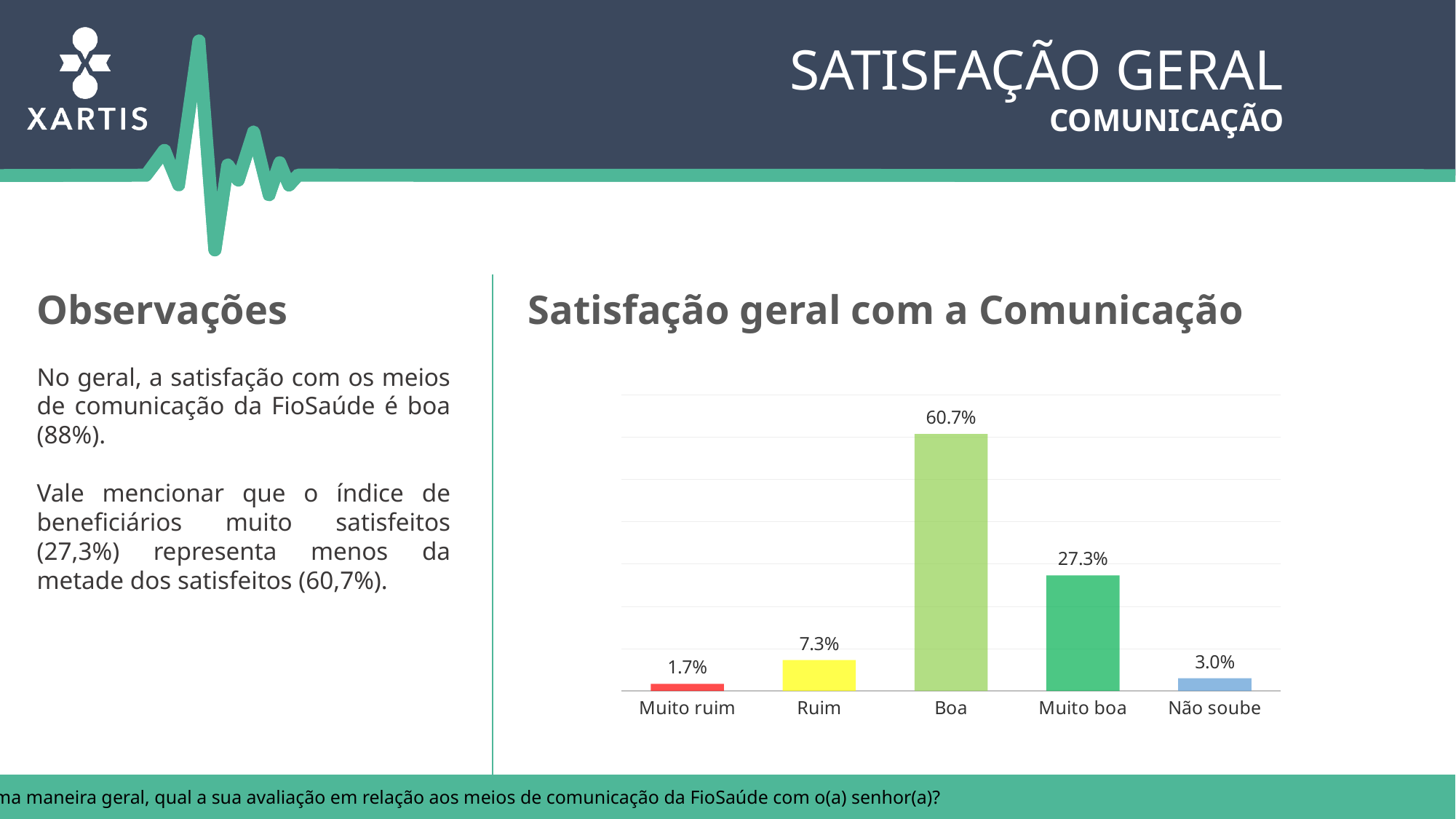
Which is larger, the value for Ruim or the value for Não soube? Ruim What kind of chart is shown on the slide? Bar chart What is the value for Não soube? 3.0% What is the value for Muito ruim? 1.7% What is the value for Ruim? 7.3% Which category has the highest value? Boa How many categories are shown on the x axis? 5 What is the value for Boa? 60.7% What is the title of the chart? Satisfação geral com a Comunicação Which category has the lowest value? Muito ruim What is the difference between the values for Boa and Muito boa? 33.4% What is the difference between the values for Ruim and Não soube? 4.3%